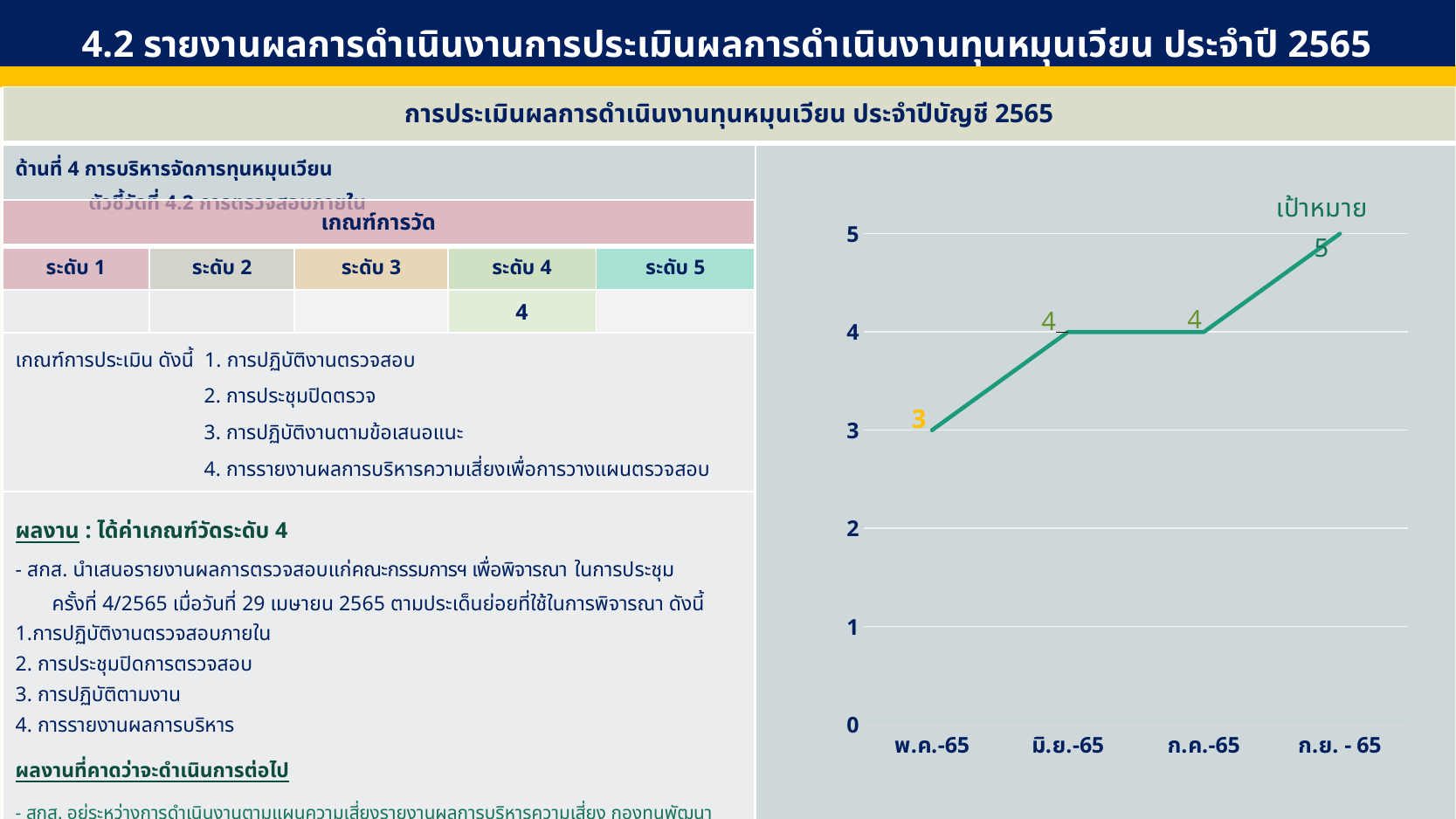
How many data points are plotted in the line chart? 4 Do the values in the line chart rise or fall from left to right along the x axis? rise What label is written next to the last point of the line chart? เป้าหมาย Which category has the highest value in the line chart? ก.ย. - 65 Which category has the lowest value in the line chart? พ.ค.-65 What is the difference between the values for ก.ย. - 65 and พ.ค.-65 in the line chart? 2 Which is larger in the line chart, the value for มิ.ย.-65 or the value for พ.ค.-65? มิ.ย.-65 What is the value for ก.ย. - 65 in the line chart? 5 What is the value for พ.ค.-65 in the line chart? 3 What kind of chart is shown on the right side of the slide? line chart What is the value for มิ.ย.-65 in the line chart? 4 What is the value for ก.ค.-65 in the line chart? 4